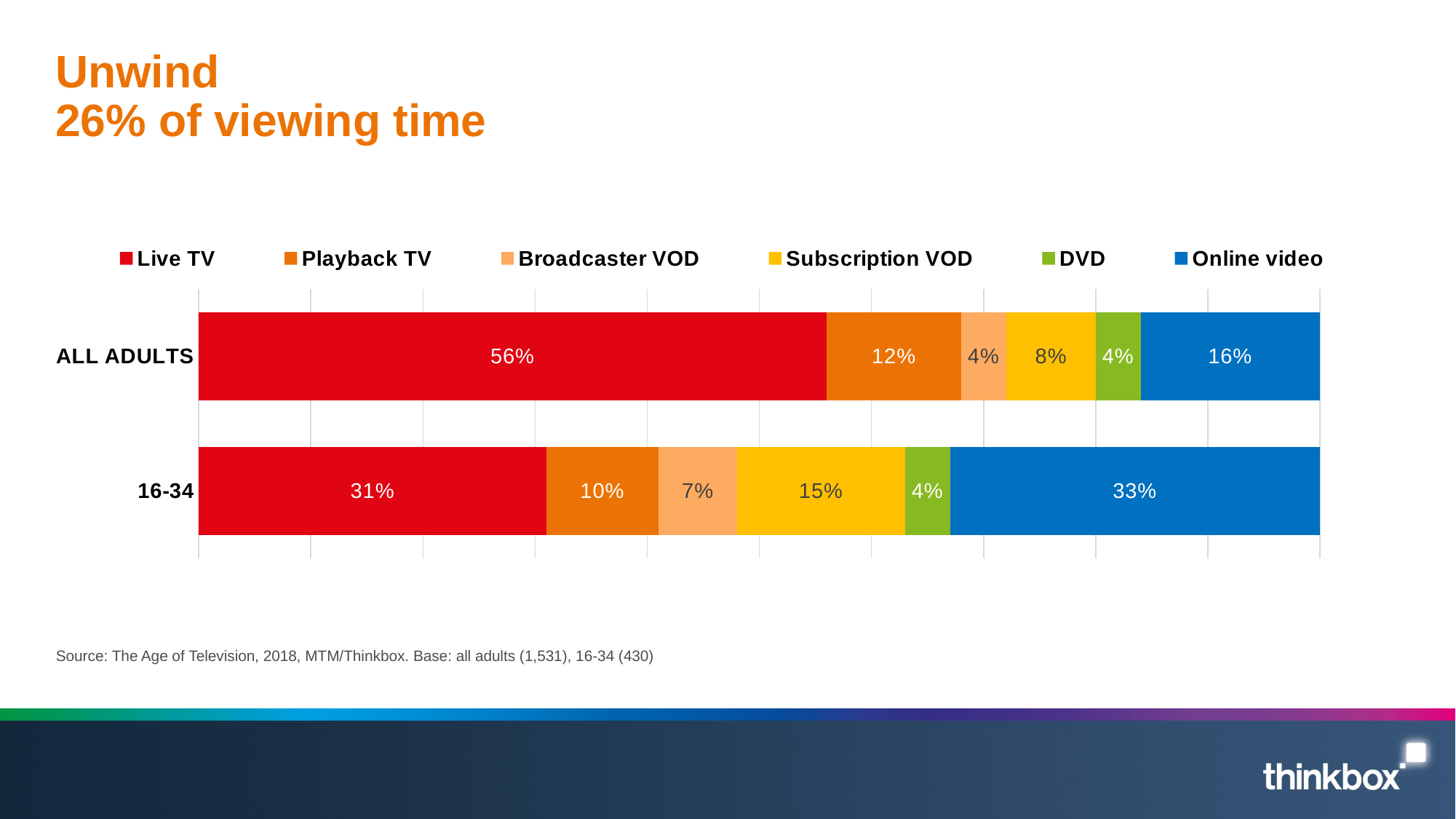
What is the Playback TV value for ALL ADULTS? 12% What share of viewing time is Live TV for ALL ADULTS? 56% What kind of chart is shown on the slide? Stacked horizontal bar chart Which group has a larger Online video share, ALL ADULTS or 16-34? 16-34 How many series does the legend list? 6 Which series has the largest share for ALL ADULTS? Live TV Which series has the largest share for the 16-34 group? Online video What is the Subscription VOD value for the 16-34 group? 15% What is the difference between the Live TV share for ALL ADULTS and for 16-34? 25 percentage points What share of viewing time is Online video for the 16-34 group? 33% Which colour represents Subscription VOD in the chart? Yellow How many groups (bars) are shown in the chart? 2